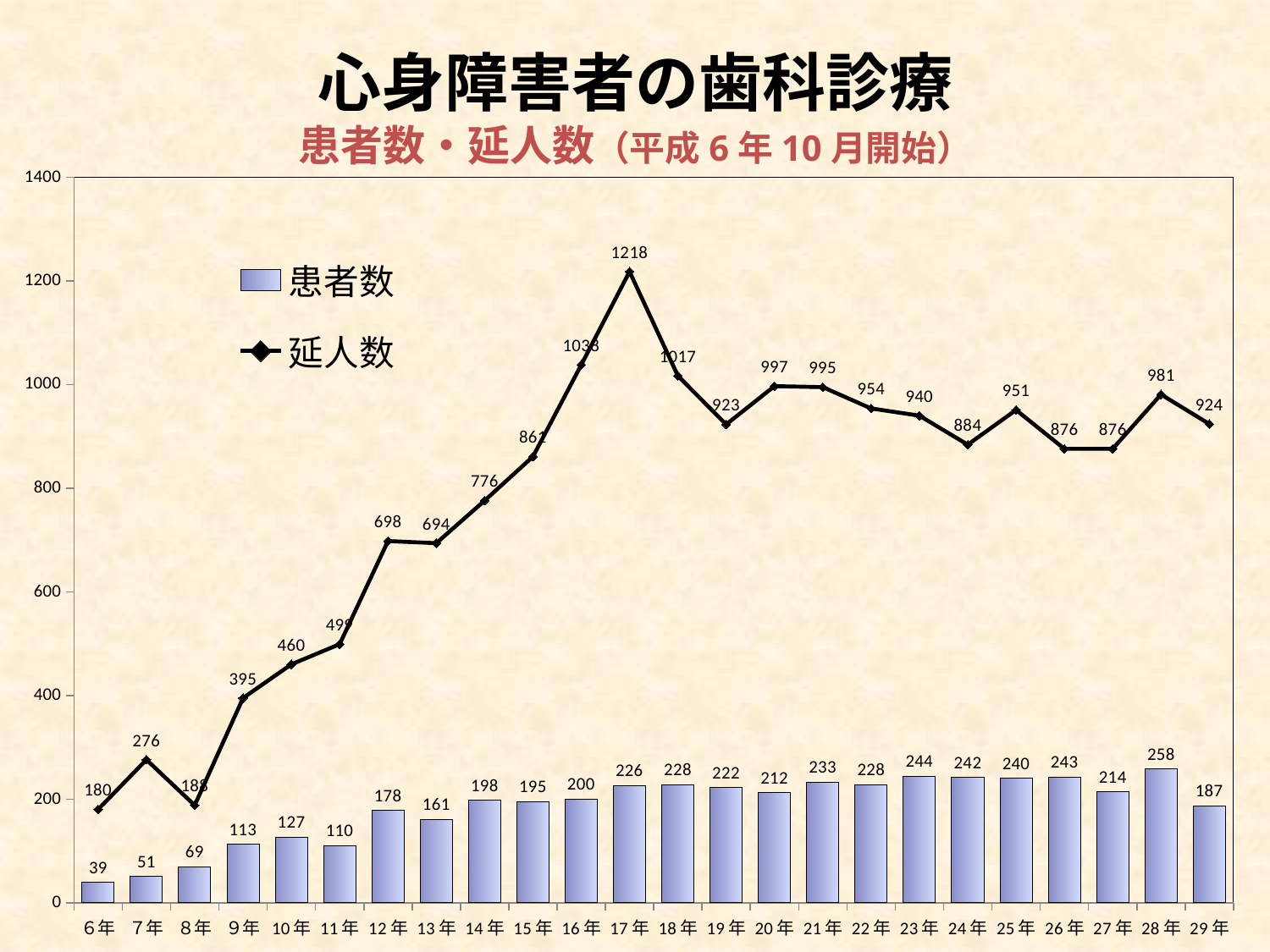
What is the difference between the 延人数 values for 17年 and 18年? 201 Which year has the highest 患者数 value? 28年 Does the 延人数 series rise or fall from 6年 to 17年? rise What kind of chart is used for the 患者数 series? bar chart What is the difference between the 患者数 values for 28年 and 29年? 71 Which year has the highest 延人数 value? 17年 How many series does the legend list? 2 What is the 延人数 value for 12年? 698 Which is larger, the 患者数 value for 23年 or for 29年? 23年 Which year has the lowest 患者数 value? 6年 How many years are shown on the x axis? 24 What is the 患者数 value for 17年? 226